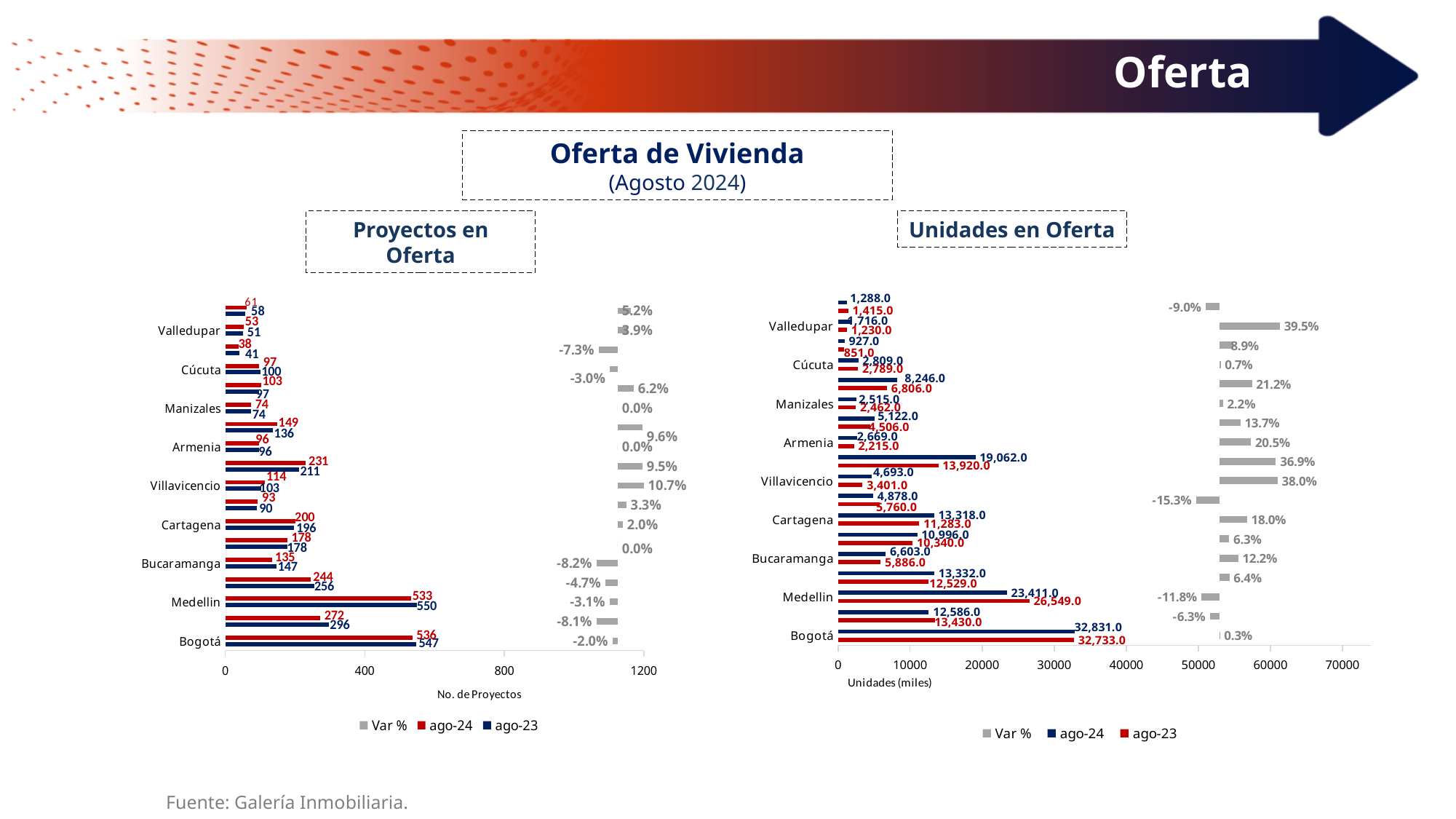
In the 'Unidades en Oferta' chart, which is larger for Medellin, the ago-24 value or the ago-23 value? ago-23 In the 'Unidades en Oferta' chart, what is the difference between the ago-24 and ago-23 values for Bogotá? 98.0 In the 'Unidades en Oferta' chart, what is the ago-24 value for Bogotá? 32,831.0 In the 'Unidades en Oferta' chart, what is the Var % shown for Valledupar? 39.5% In the 'Proyectos en Oferta' chart, how much larger is the ago-23 value than the ago-24 value for Bucaramanga? 12 In the 'Unidades en Oferta' chart, what is the ago-23 value for Medellin? 26,549.0 In the 'Proyectos en Oferta' chart, what is the ago-23 value for Medellin? 550 In the 'Proyectos en Oferta' chart, what is the Var % shown for Villavicencio? 10.7% In the 'Proyectos en Oferta' chart, what is the ago-24 value for Bogotá? 536 What kind of chart is the 'Proyectos en Oferta' chart? bar chart How many series does the legend of the 'Proyectos en Oferta' chart list? 3 What is the x-axis title of the 'Unidades en Oferta' chart? Unidades (miles)